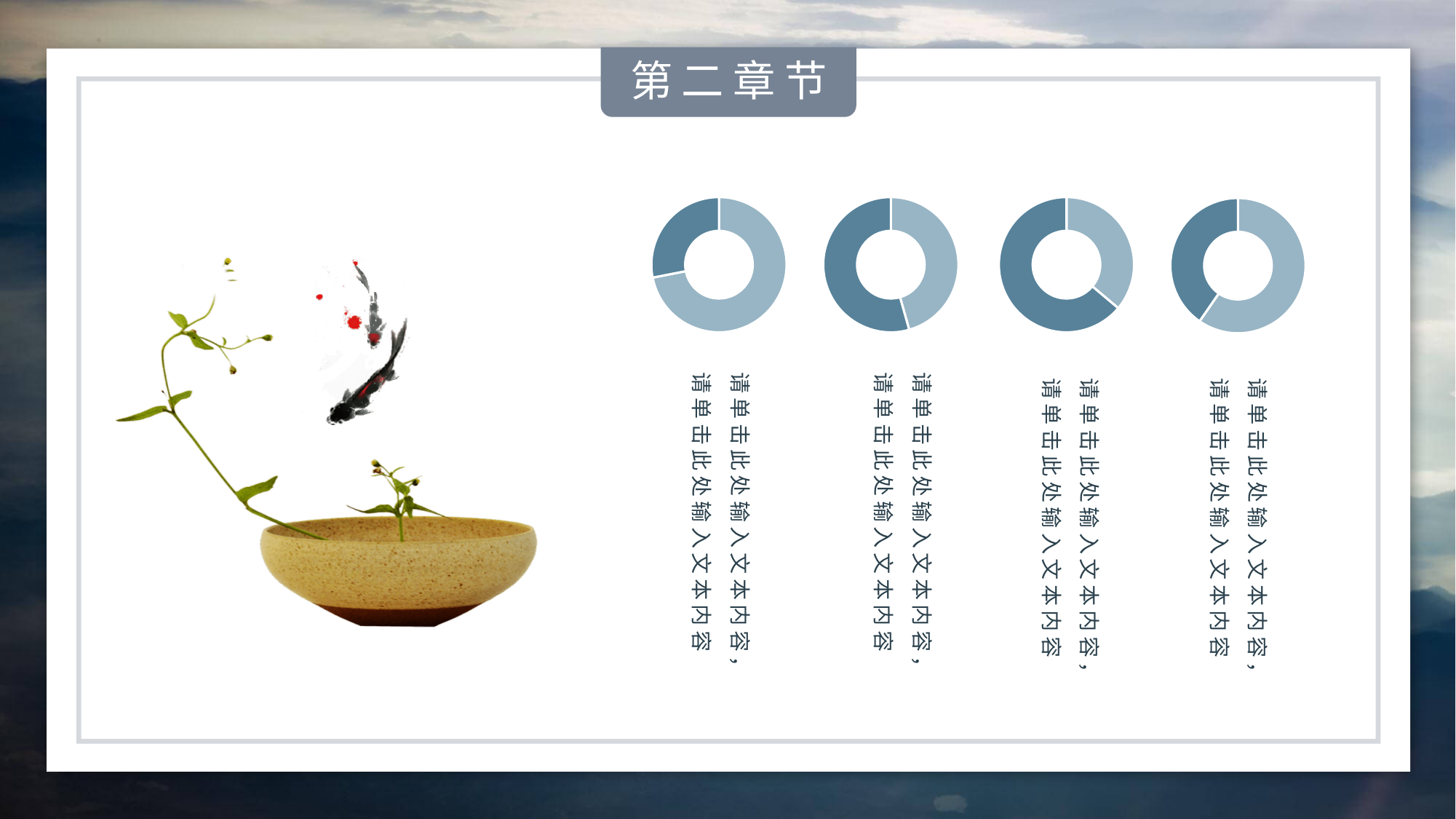
In the third donut chart from the left, which slice is larger, the dark blue one or the light blue one? The dark blue one Do the donut charts on the slide display any data labels with values? No Do the donut charts on the slide have a legend? No What kind of chart is the leftmost chart on the slide? Donut (pie) chart How many donut charts are shown on the slide? 4 How many slices does the rightmost donut chart have? 2 In the leftmost donut chart, which slice is larger, the dark blue one or the light blue one? The light blue one How many slices does the leftmost donut chart have? 2